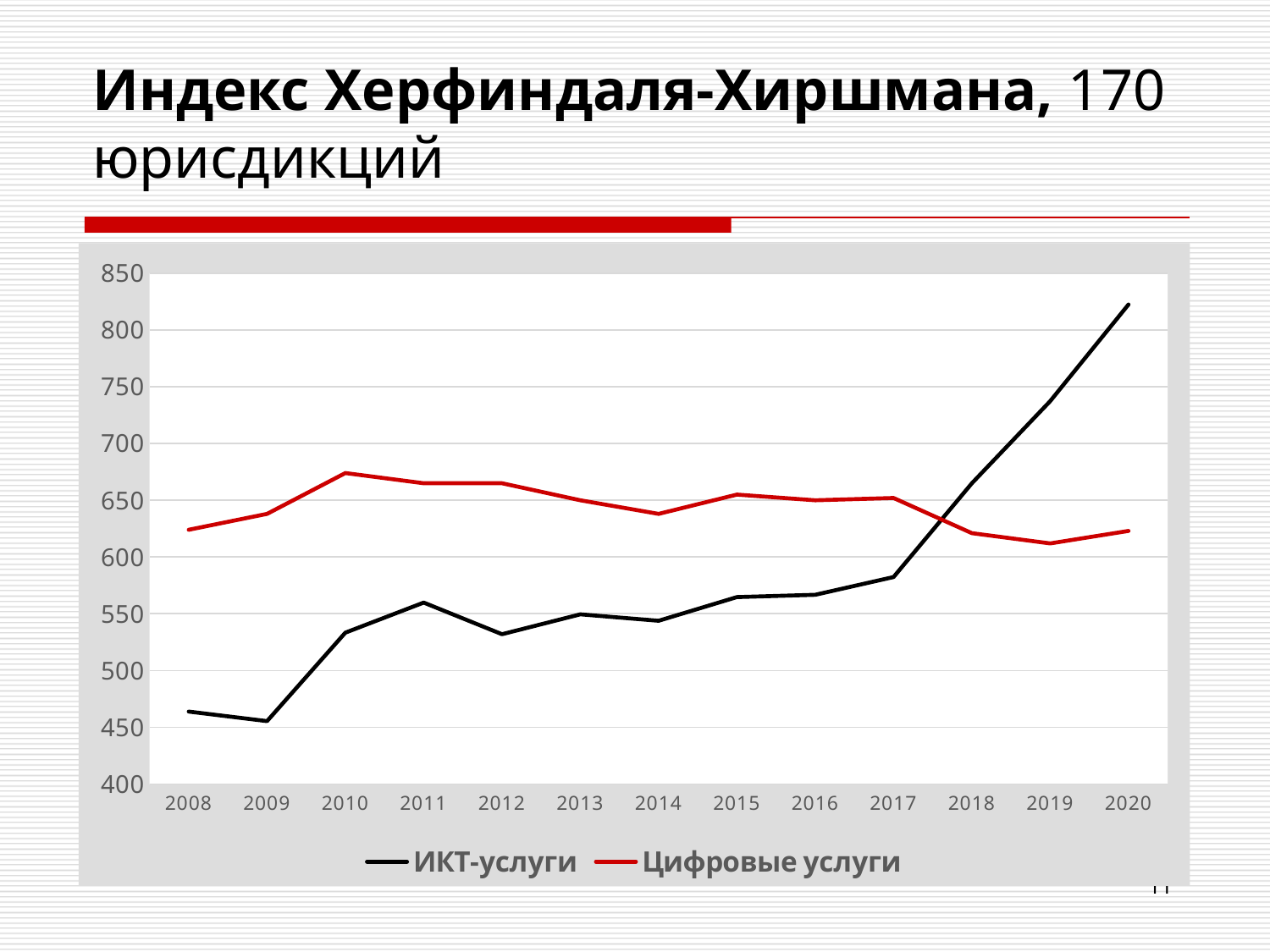
Is the value for ИКТ-услуги in 2020 greater or less than 800? greater In which year does the ИКТ-услуги series reach its highest value? 2020 Is the value for ИКТ-услуги in 2008 greater or less than 500? less In which year does the Цифровые услуги series reach its highest value? 2010 In which year does the ИКТ-услуги series have its lowest value? 2009 In 2020, which series has the higher value, ИКТ-услуги or Цифровые услуги? ИКТ-услуги What kind of chart is shown on the slide? line chart In 2008, which series has the higher value, ИКТ-услуги or Цифровые услуги? Цифровые услуги How many years are shown on the x axis? 13 How many series does the legend list? 2 Is the value for Цифровые услуги in 2010 greater or less than 650? greater Does the ИКТ-услуги series rise or fall from 2017 to 2020? rise